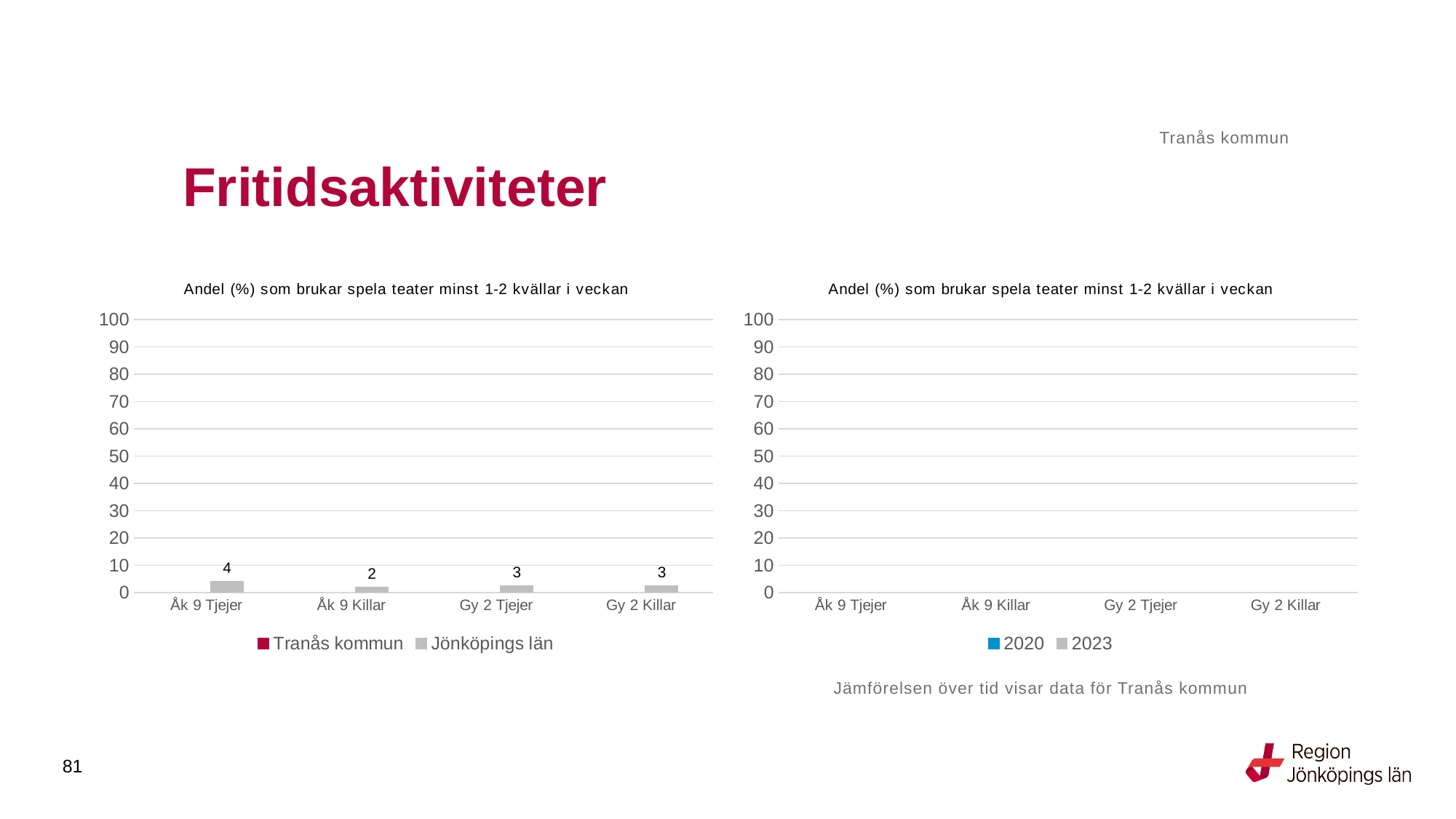
In the left chart, is the Jönköpings län value for Åk 9 Tjejer greater or less than 10? less In the left chart, which is larger for Jönköpings län: Åk 9 Tjejer or Gy 2 Tjejer? Åk 9 Tjejer In the left chart, which category has the highest value for Jönköpings län? Åk 9 Tjejer In the left chart, which category has the lowest value for Jönköpings län? Åk 9 Killar How many categories are shown on the x axis of the left chart? 4 In the left chart, what is the value for Jönköpings län for Åk 9 Tjejer? 4 In the left chart, what is the difference between the Jönköpings län values for Åk 9 Tjejer and Åk 9 Killar? 2 What kind of chart is the left chart? bar chart In the left chart, what is the value for Jönköpings län for Åk 9 Killar? 2 In the left chart, what is the value for Jönköpings län for Gy 2 Tjejer? 3 How many series does the legend of the left chart list? 2 In the left chart, what is the value for Jönköpings län for Gy 2 Killar? 3